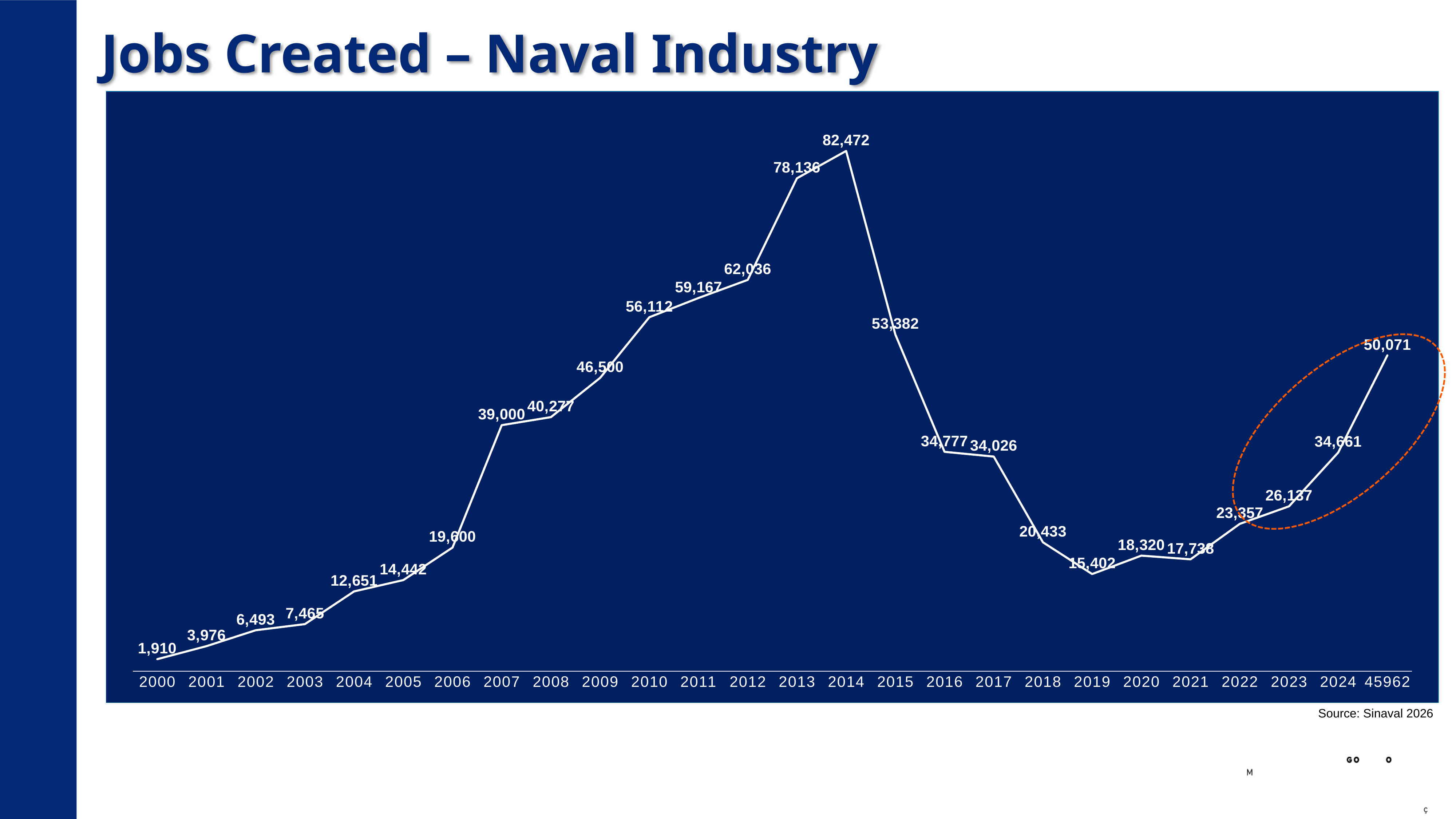
What is the value shown for 2007? 39,000 Which year has the highest number of jobs created? 2014 What is the title of the slide's chart? Jobs Created – Naval Industry Do the values rise or fall from 2014 to 2019? Fall What is the value shown for 2019? 15,402 What is the difference between the values for 2024 and 2023? 8,524 Which year has the lowest number of jobs created? 2000 What is the difference between the values for 2014 and 2013? 4,336 Which is larger, the value for 2015 or the value for 2016? 2015 How many data points are plotted on the line? 26 What type of chart is shown on the slide? Line chart How many jobs were created in 2014? 82,472